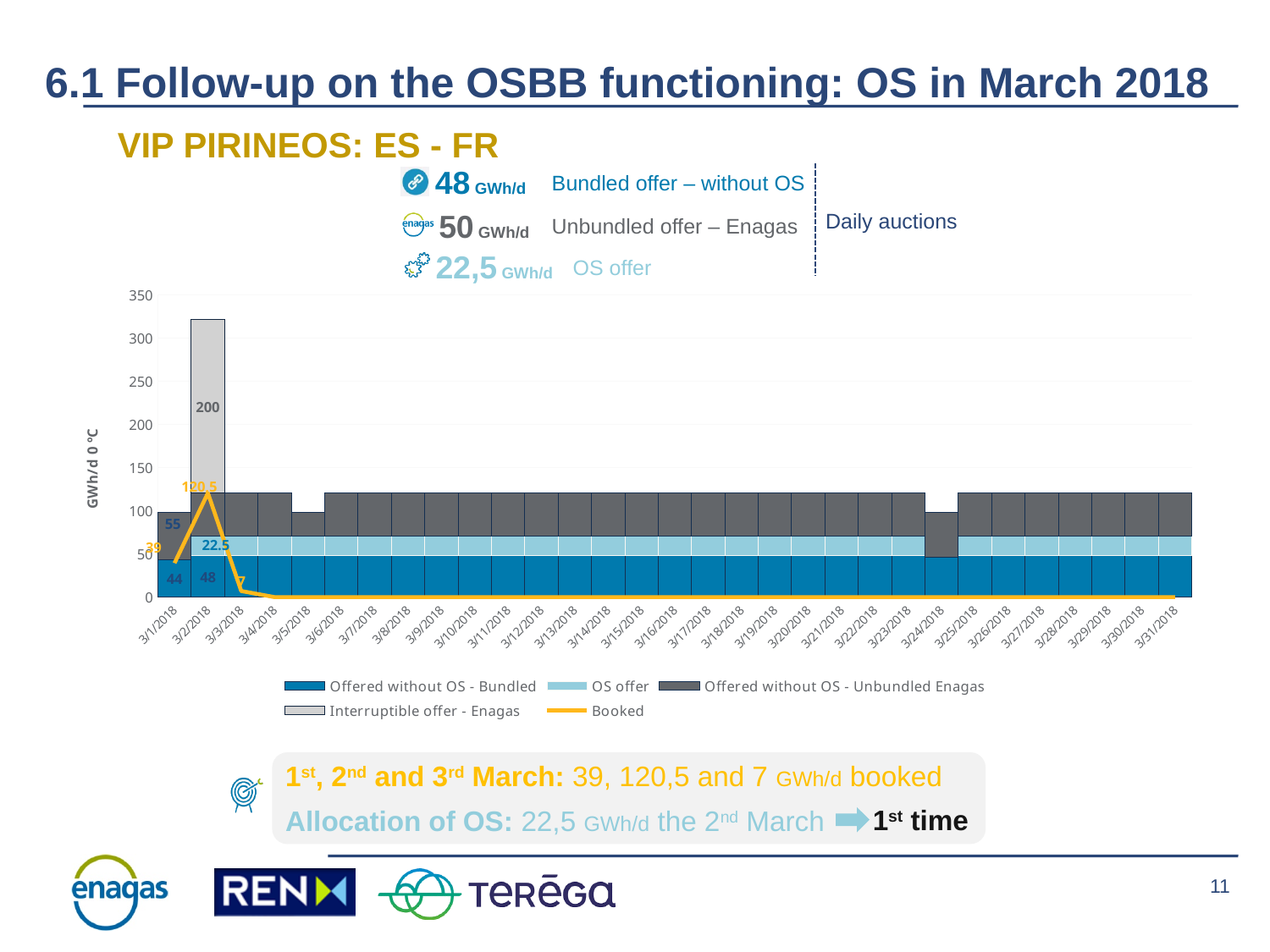
What type of chart is shown on the slide? Stacked bar chart with a line How many series does the chart legend list? 5 What is the Interruptible offer - Enagas value on 3/2/2018? 200 What is the Booked value on 3/1/2018? 39 How many dates are shown on the x axis of the chart? 31 What is the Booked value on 3/3/2018? 7 What is the Offered without OS - Unbundled Enagas value on 3/1/2018? 55 Is the total height of the stacked bar on 3/2/2018 greater or less than 300? greater What is the Booked value on 3/2/2018? 120,5 What is the difference between the Booked value on 3/2/2018 and on 3/1/2018? 81,5 What is the Offered without OS - Bundled value on 3/1/2018? 44 On which date is the Booked value highest? 3/2/2018